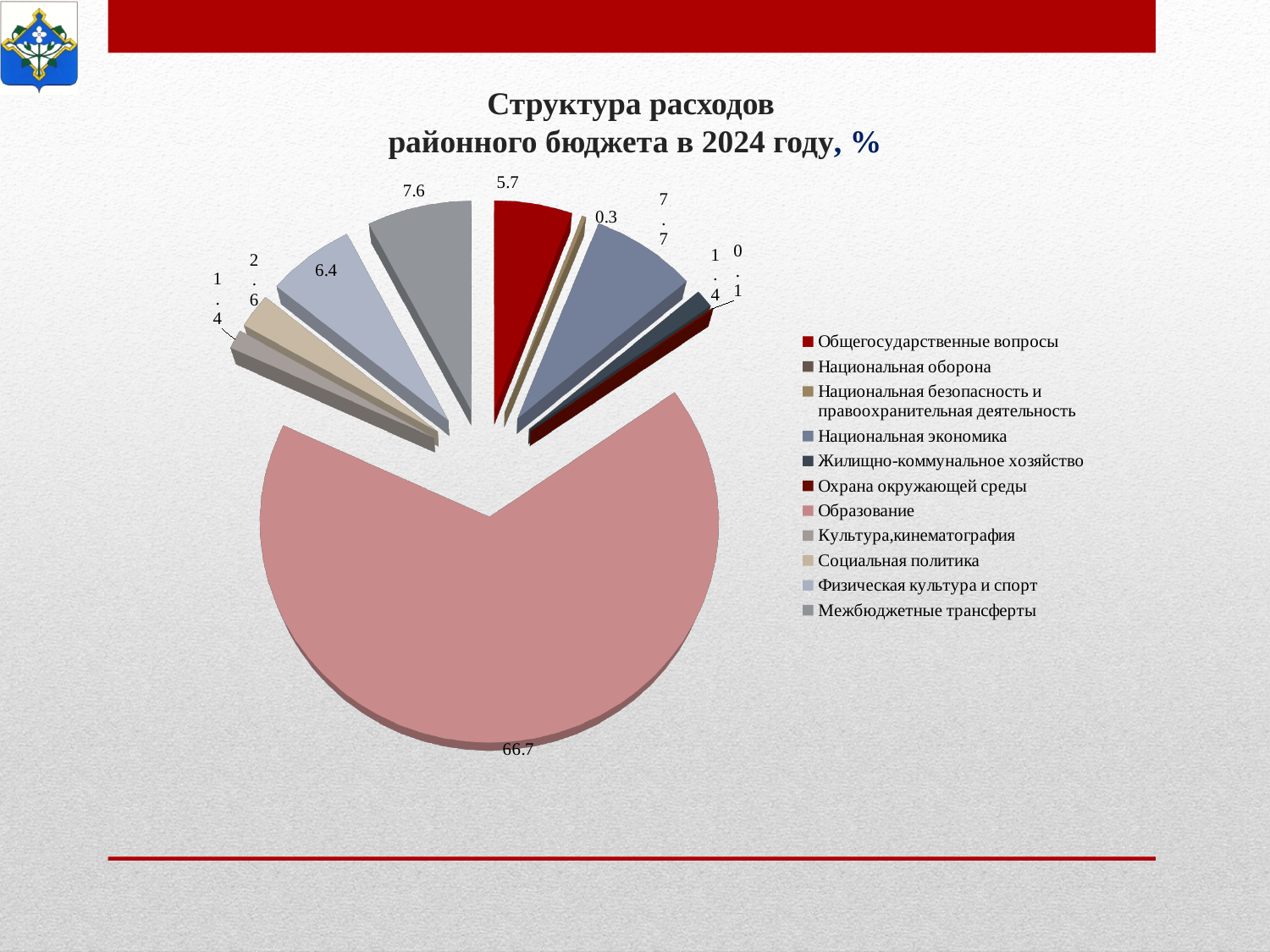
What is the value for Образование? 66.7 What is the value for Межбюджетные трансферты? 7.6 Which category has the largest share of the pie? Образование What is the value for Национальная экономика? 7.7 Which is larger, the share for Образование or the share for Общегосударственные вопросы? Образование What is the difference between the values for Образование and Национальная экономика? 59.0 How many categories does the legend list? 11 What kind of chart is shown on the slide? pie chart What is the value for Общегосударственные вопросы? 5.7 What is the value for Физическая культура и спорт? 6.4 What is the title of the chart? Структура расходов районного бюджета в 2024 году, % What is the value for Социальная политика? 2.6